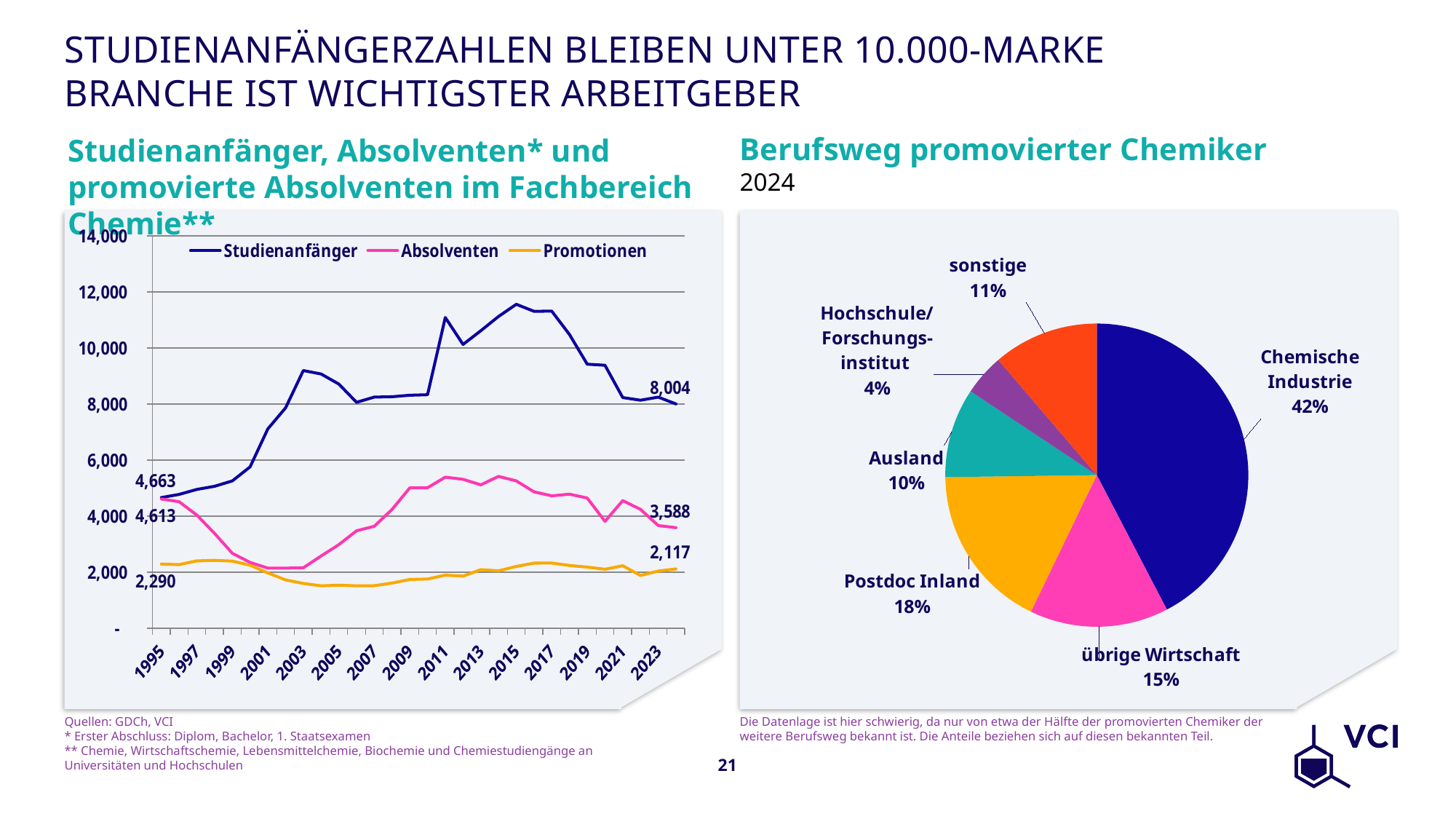
In the pie chart 'Berufsweg promovierter Chemiker', how many percentage points larger is 'Postdoc Inland' than 'übrige Wirtschaft'? 3 percentage points In the pie chart 'Berufsweg promovierter Chemiker', which category has the smallest slice? Hochschule/Forschungsinstitut In the pie chart 'Berufsweg promovierter Chemiker', what share does 'Chemische Industrie' have? 42% In the left chart, what is the value of 'Studienanfänger' in 1995? 4,663 What kind of chart is the chart on the right of the slide? Pie chart How many series does the legend of the left chart ('Studienanfänger, Absolventen* und promovierte Absolventen im Fachbereich Chemie**') list? 3 In the left chart, what is the most recent labelled value of 'Studienanfänger'? 8,004 How many slices does the pie chart 'Berufsweg promovierter Chemiker' have? 6 In the left chart, is the value for 'Studienanfänger' in 2015 greater or less than 10,000? greater In the left chart, what is the most recent labelled value of 'Promotionen'? 2,117 In the pie chart 'Berufsweg promovierter Chemiker', which category has the largest slice? Chemische Industrie What kind of chart is the chart on the left of the slide? Line chart